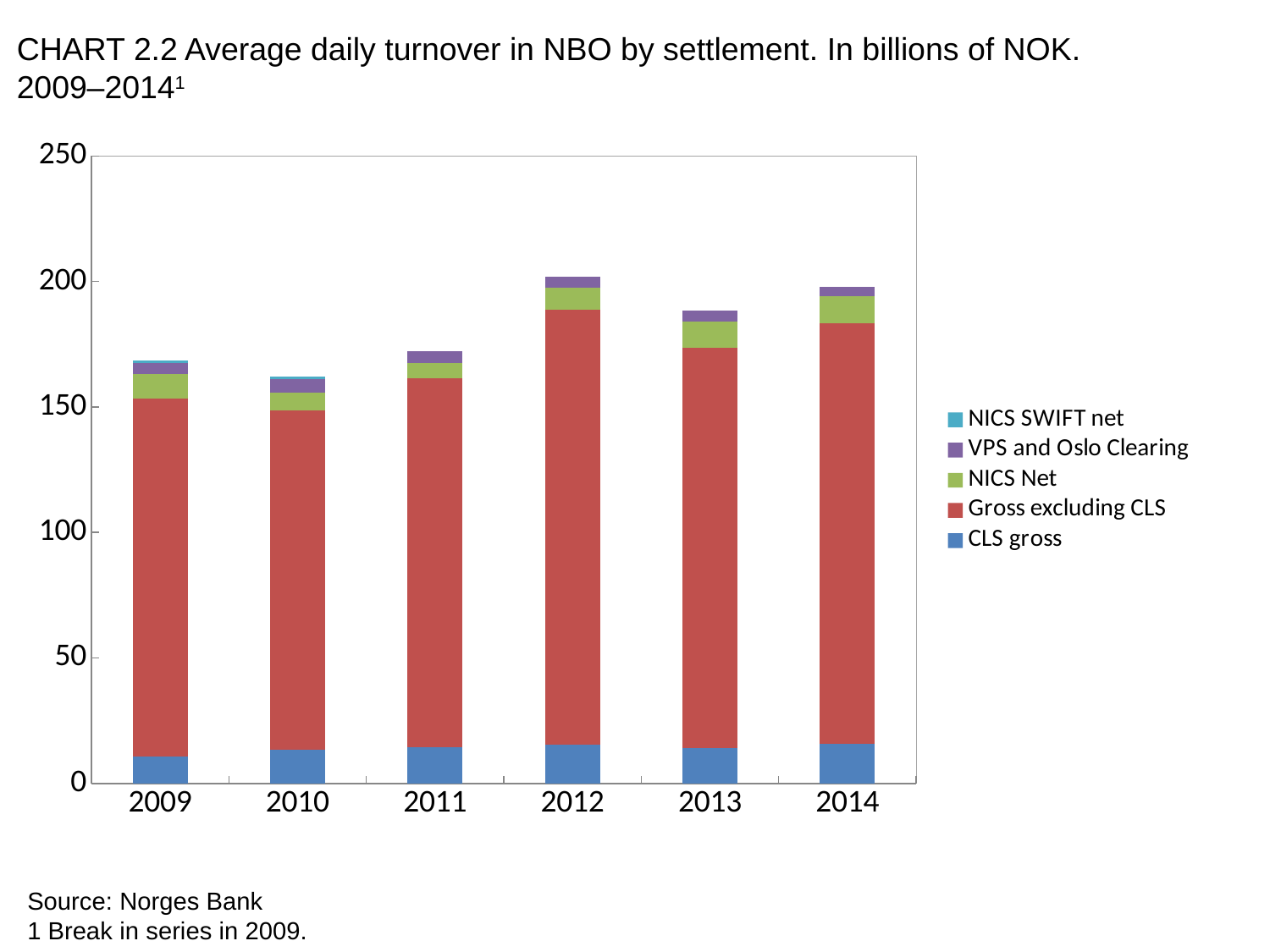
Is the total bar for 2010 greater or less than 150? greater Which year has the lowest total average daily turnover? 2010 Is the total bar for 2013 greater or less than 200? less How many years are shown on the x axis of the chart? 6 Which year has the larger total bar, 2012 or 2013? 2012 Which series forms the bottom segment of each stacked bar? CLS gross Which year has the highest total average daily turnover? 2012 How many series does the legend list? 5 Is the total bar for 2012 greater or less than 200? greater What kind of chart is shown on the slide? Stacked bar chart Which series is shown in red in the chart? Gross excluding CLS Does the total turnover rise or fall from 2010 to 2012? rise